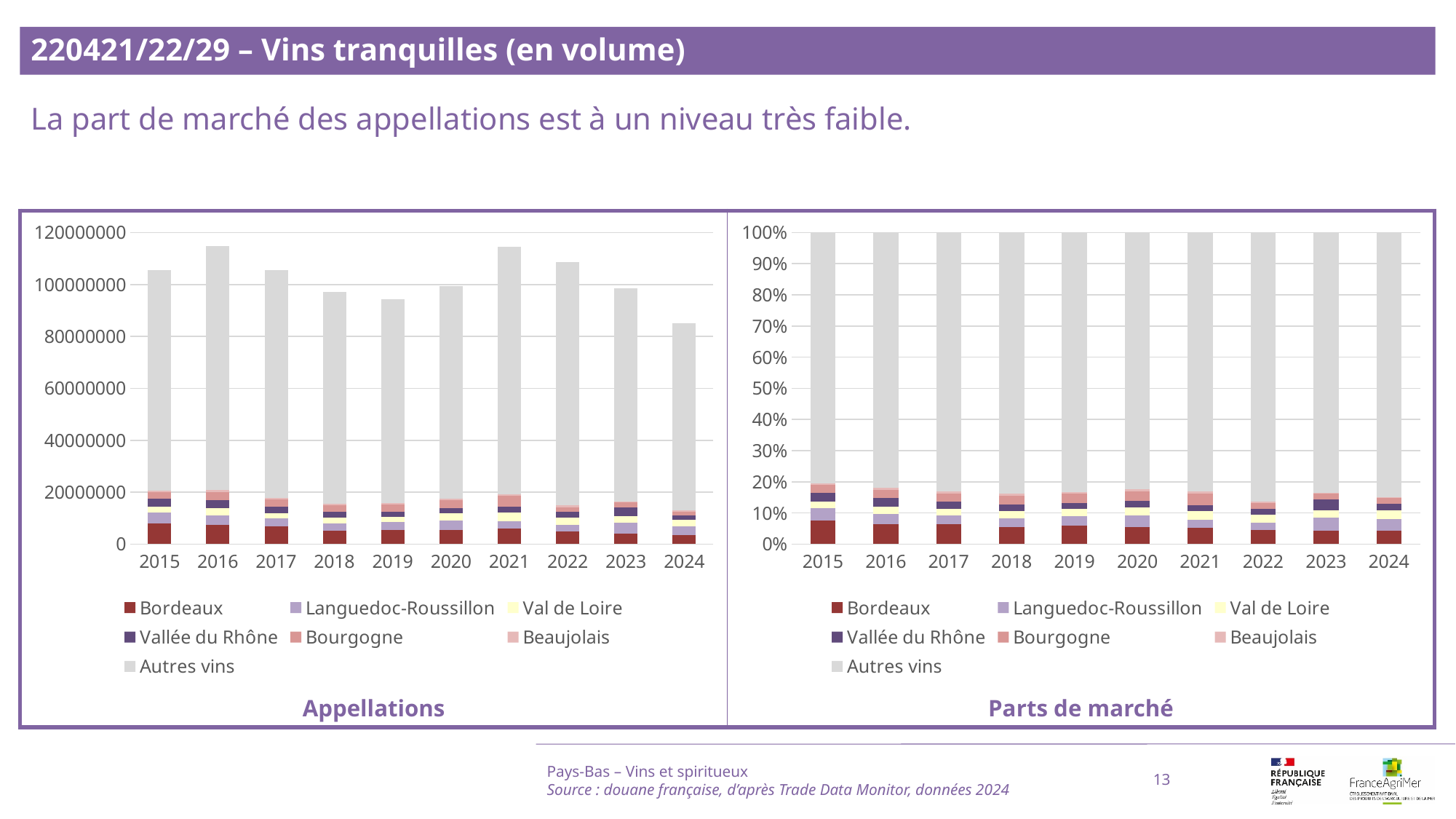
In the Appellations chart, is the total for 2019 greater or less than 100000000? less In the Parts de marché chart, is the share of Autres vins in 2024 greater or less than 80%? greater In the Appellations chart, is the total for 2016 greater or less than 100000000? greater In the Appellations chart, which total bar is larger, 2021 or 2019? 2021 In the Appellations chart, which year has the lowest total bar? 2024 How many years are shown on the x axis of the Appellations chart? 10 How many series does the legend of the Parts de marché chart list? 7 Which series is shown in grey in both charts? Autres vins In the Appellations chart, which total bar is larger, 2016 or 2024? 2016 In the Parts de marché chart, what is the total of the stacked bar for 2020? 100% What kind of chart is the Appellations chart on the left? Stacked bar chart